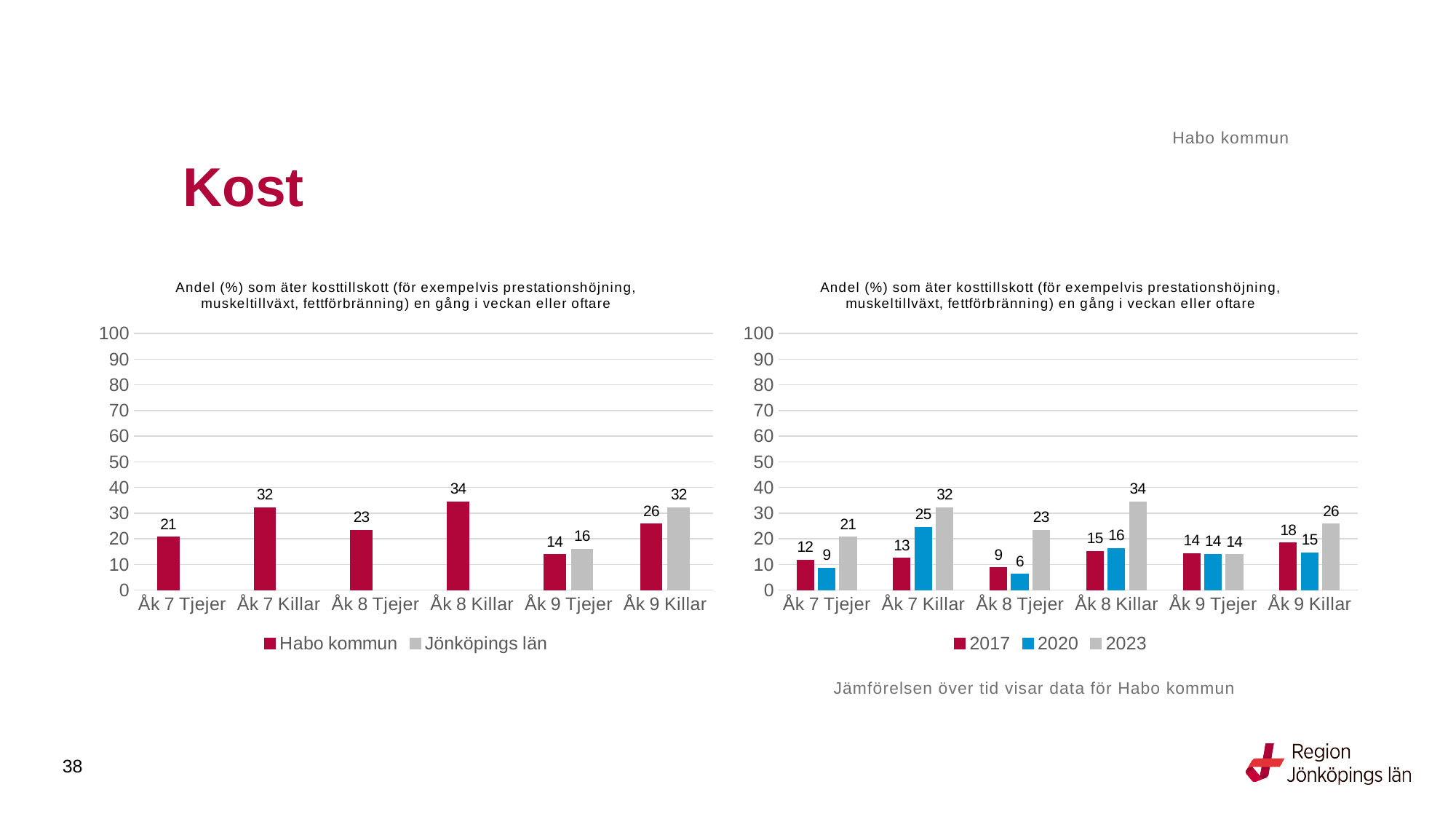
In the left chart, what is the value for Jönköpings län for Åk 9 Tjejer? 16 In the right chart, which category has the highest 2023 value? Åk 8 Killar In the right chart, which is larger for Åk 9 Killar: the 2017 value or the 2020 value? 2017 In the right chart, what is the 2020 value for Åk 7 Killar? 25 What type of chart is the right chart? Bar chart In the left chart, how many series does the legend list? 2 In the right chart, what is the difference between the 2023 and 2017 values for Åk 7 Tjejer? 9 In the left chart, what is the difference between the Jönköpings län and Habo kommun values for Åk 9 Killar? 6 In the right chart, how many categories are shown on the x axis? 6 In the left chart, which category has the lowest Habo kommun value? Åk 9 Tjejer In the left chart, what is the value for Habo kommun for Åk 8 Killar? 34 In the right chart, what is the 2017 value for Åk 8 Tjejer? 9